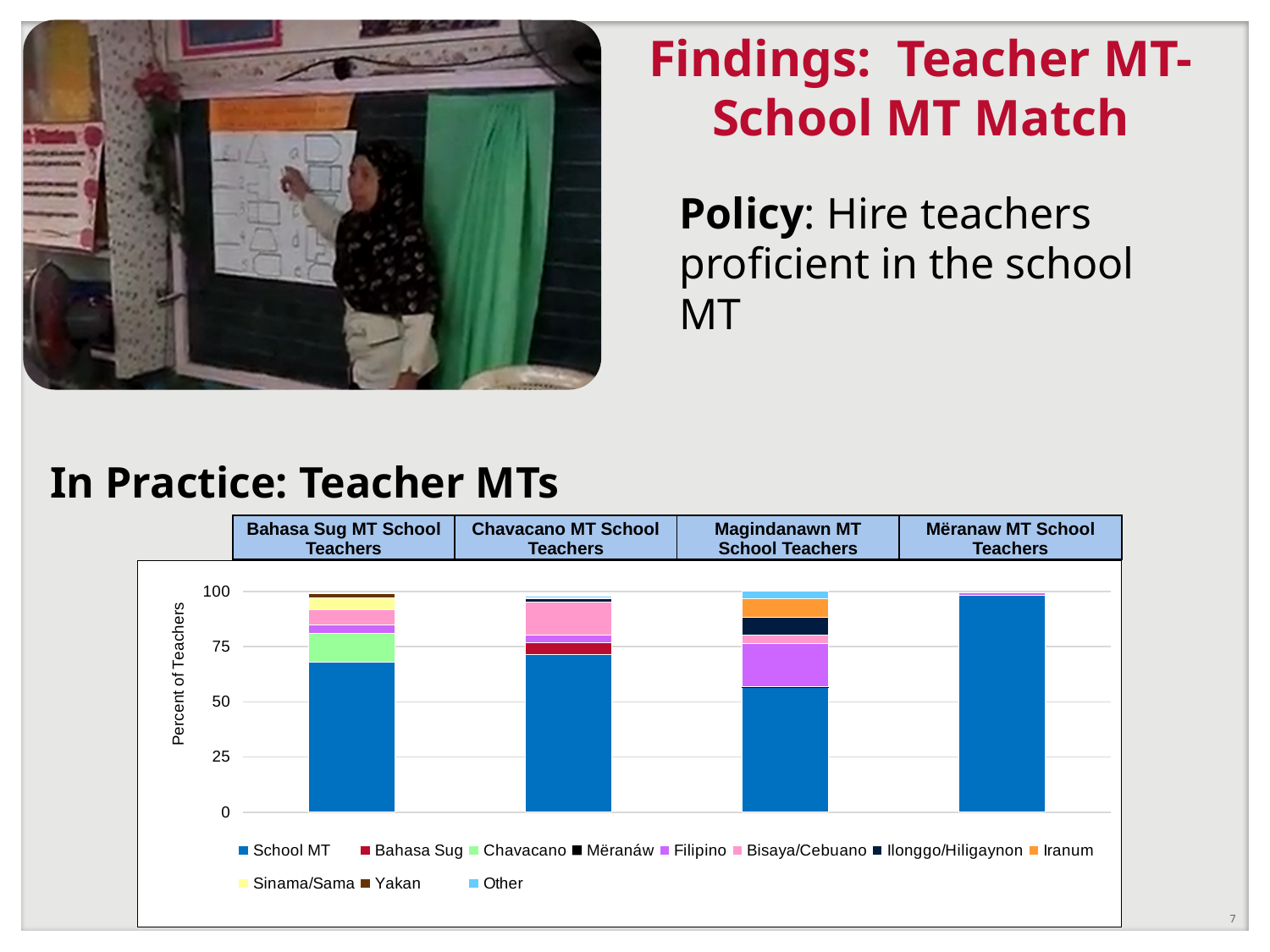
What is the label on the vertical axis of the chart? Percent of Teachers Is the School MT value for Magindanawn MT School Teachers greater or less than 75? less Which school-teacher group has the largest School MT share? Mëranaw MT School Teachers Which series is listed first in the chart legend? School MT Is the School MT value for Mëranaw MT School Teachers greater or less than 75? greater What kind of chart is shown on the slide? Stacked bar chart Which has a larger School MT share: Mëranaw MT School Teachers or Magindanawn MT School Teachers? Mëranaw MT School Teachers Is the School MT value for Bahasa Sug MT School Teachers greater or less than 75? less How many school-teacher groups (categories) are plotted on the chart? 4 How many series does the chart legend list? 11 Which school-teacher group has the smallest School MT share? Magindanawn MT School Teachers